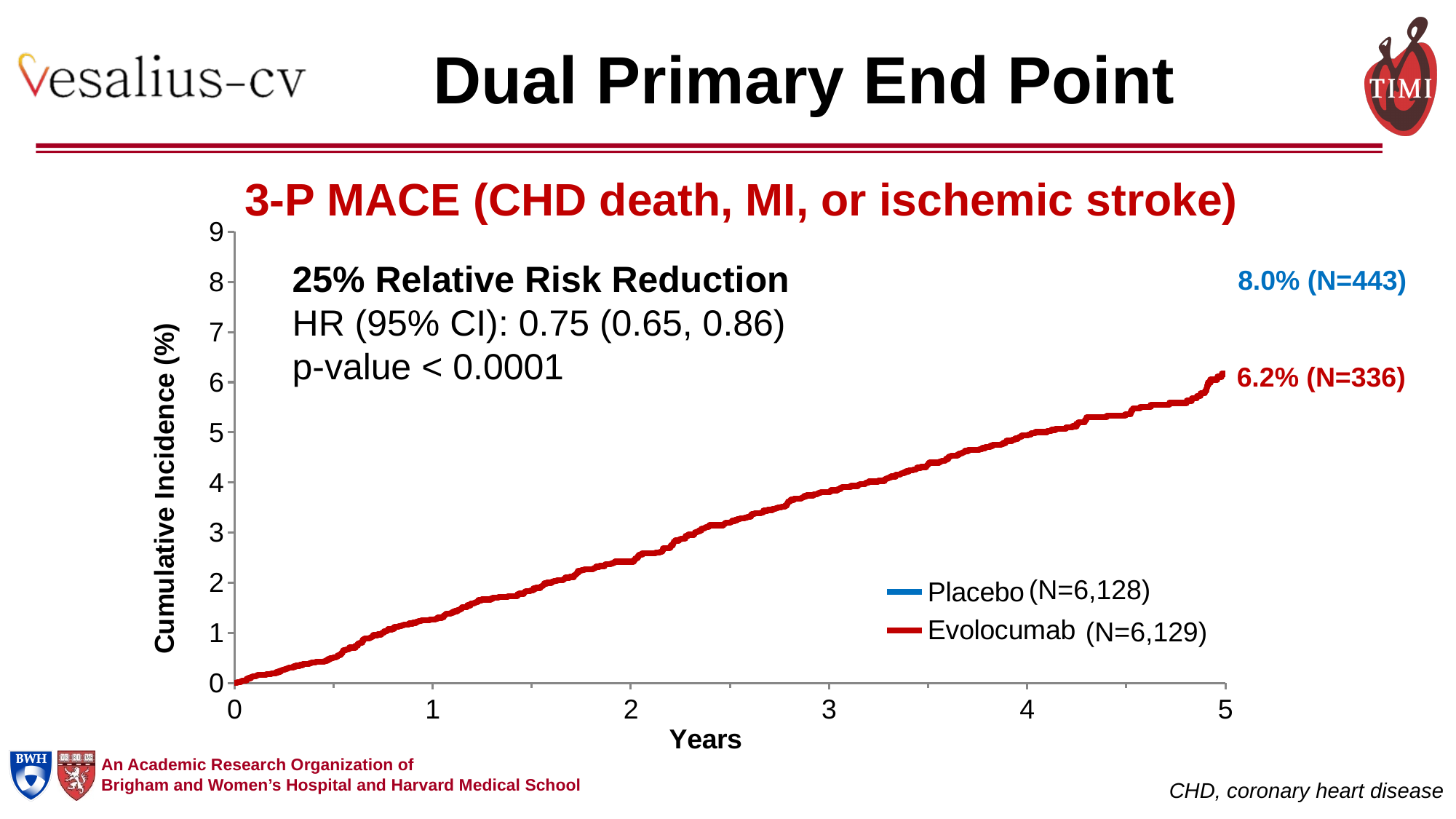
Does the Evolocumab curve rise or fall over the years? Rises How many events (N) are shown for the Placebo group? 443 What is the label of the y-axis? Cumulative Incidence (%) Is the cumulative incidence for Evolocumab at 3 years greater or less than 4%? less What is the difference in cumulative incidence between the Placebo and Evolocumab groups at the end of follow-up? 1.8% How many series does the legend list? 2 What kind of chart is shown on the slide? Line chart What is the cumulative incidence shown for the Evolocumab group at the end of follow-up? 6.2% What is the cumulative incidence shown for the Placebo group at the end of follow-up? 8.0% How many events (N) are shown for the Evolocumab group? 336 Is the cumulative incidence for Evolocumab at 2 years greater or less than 2%? greater Which group has the higher cumulative incidence at the end of follow-up, Placebo or Evolocumab? Placebo